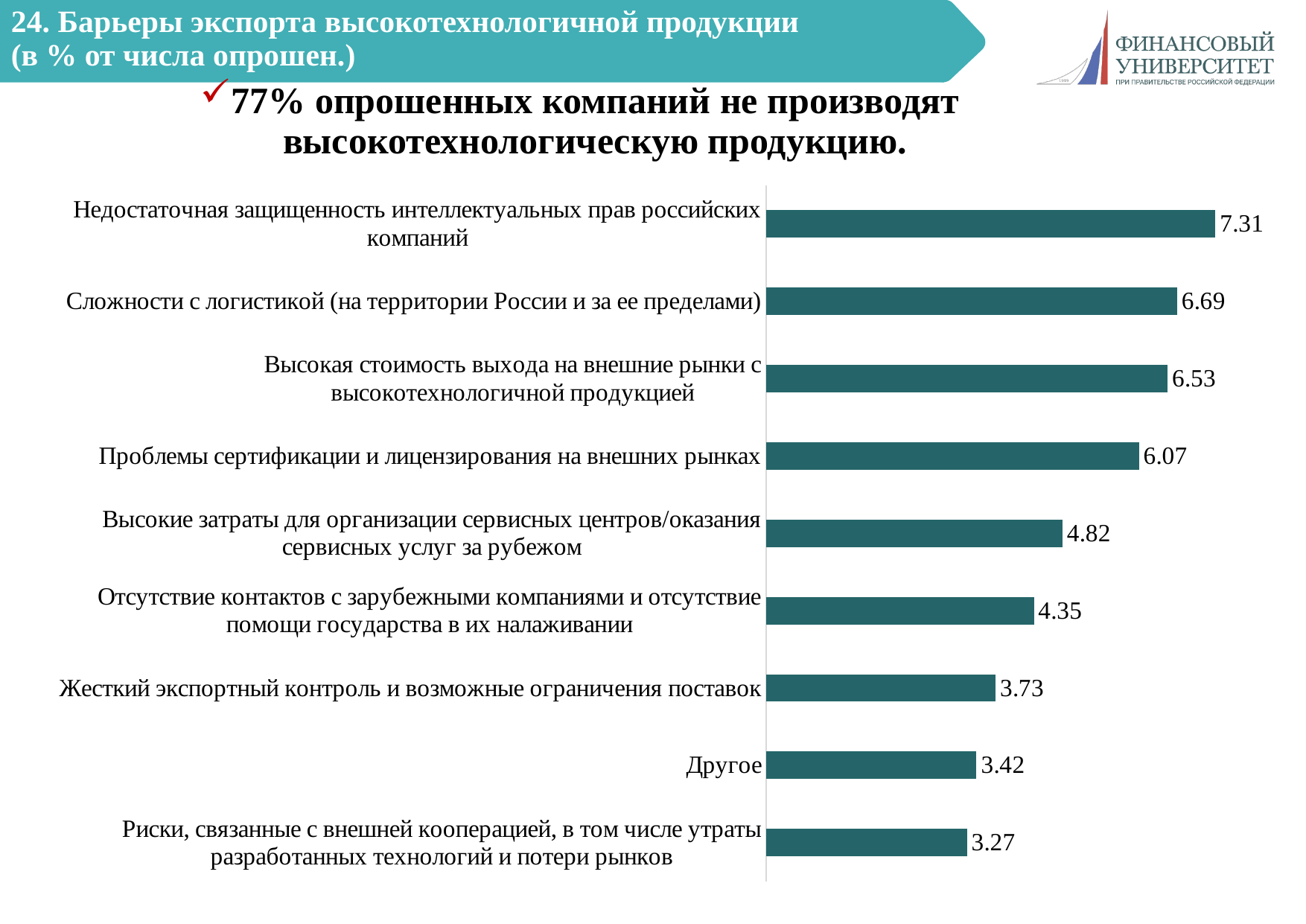
Which category has the lowest value? Риски, связанные с внешней кооперацией, в том числе утраты разработанных технологий и потери рынков According to the text above the chart, what percentage of surveyed companies do not produce high-tech products? 77% What is the difference between the highest value (7.31) and the lowest value (3.27)? 4.04 How many categories (barriers) are plotted in the chart? 9 What is the value for "Жесткий экспортный контроль и возможные ограничения поставок"? 3.73 What is the difference between "Высокие затраты для организации сервисных центров/оказания сервисных услуг за рубежом" and "Отсутствие контактов с зарубежными компаниями и отсутствие помощи государства в их налаживании"? 0.47 What kind of chart is shown on the slide? Bar chart What is the value for "Проблемы сертификации и лицензирования на внешних рынках"? 6.07 What is the value for "Другое"? 3.42 Which category has the highest value? Недостаточная защищенность интеллектуальных прав российских компаний Which is larger: the value for "Высокая стоимость выхода на внешние рынки с высокотехнологичной продукцией" or the value for "Проблемы сертификации и лицензирования на внешних рынках"? Высокая стоимость выхода на внешние рынки с высокотехнологичной продукцией What is the value for "Сложности с логистикой (на территории России и за ее пределами)"? 6.69